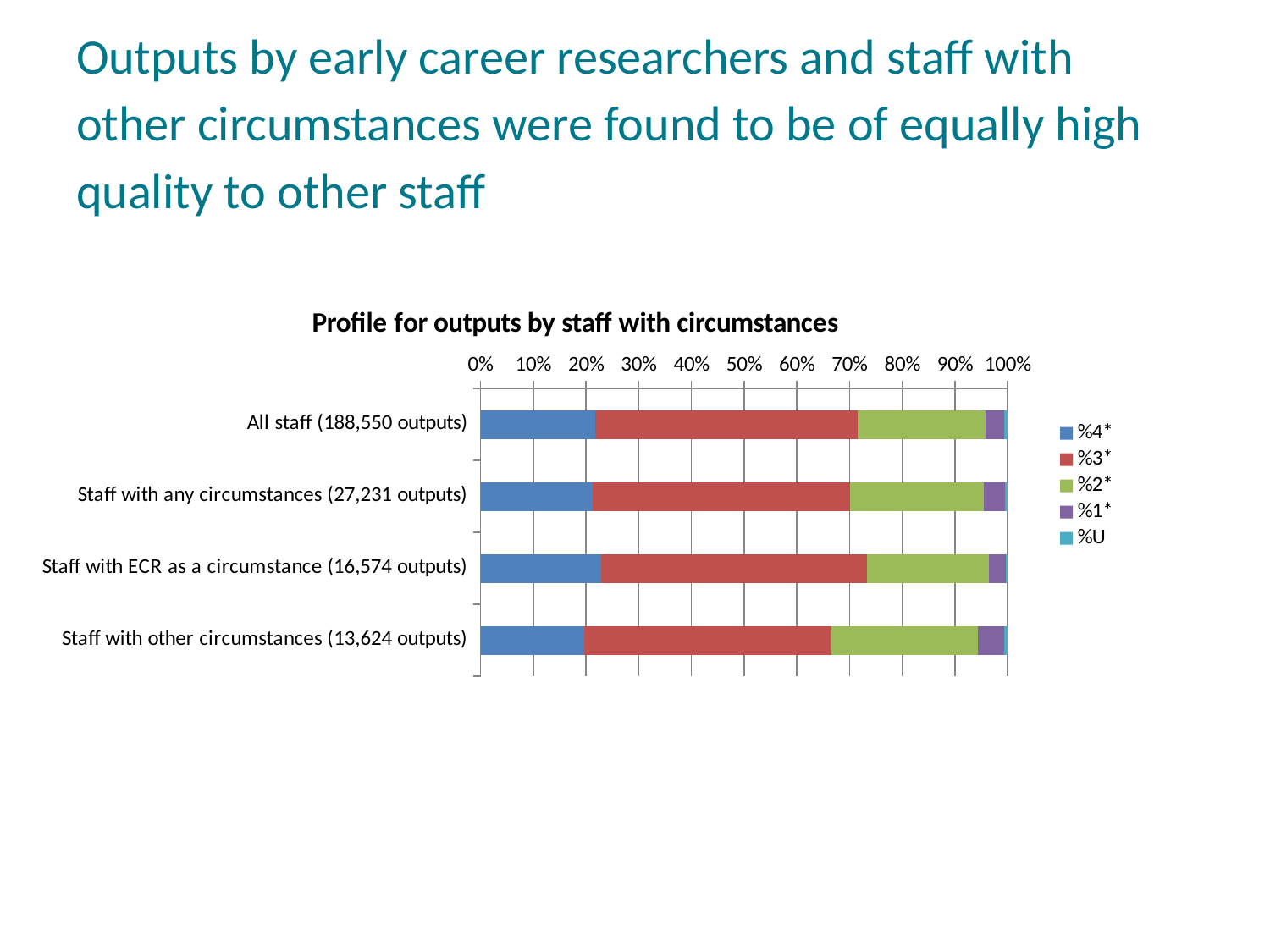
How many series does the legend list? 5 Is the %3* value for All staff greater or less than 40%? greater Which series is shown in red in the chart? %3* Which category has the largest %2* segment? Staff with other circumstances (13,624 outputs) Is the %4* value for All staff greater or less than 30%? less What type of chart is shown on the slide? Stacked bar chart Is the %1* value for Staff with ECR as a circumstance greater or less than 10%? less Which is larger, the %4* value for Staff with ECR as a circumstance or for Staff with other circumstances? Staff with ECR as a circumstance Which is larger, the %2* value for Staff with other circumstances or for All staff? Staff with other circumstances What is the title of the chart? Profile for outputs by staff with circumstances How many categories (bars) are shown in the chart? 4